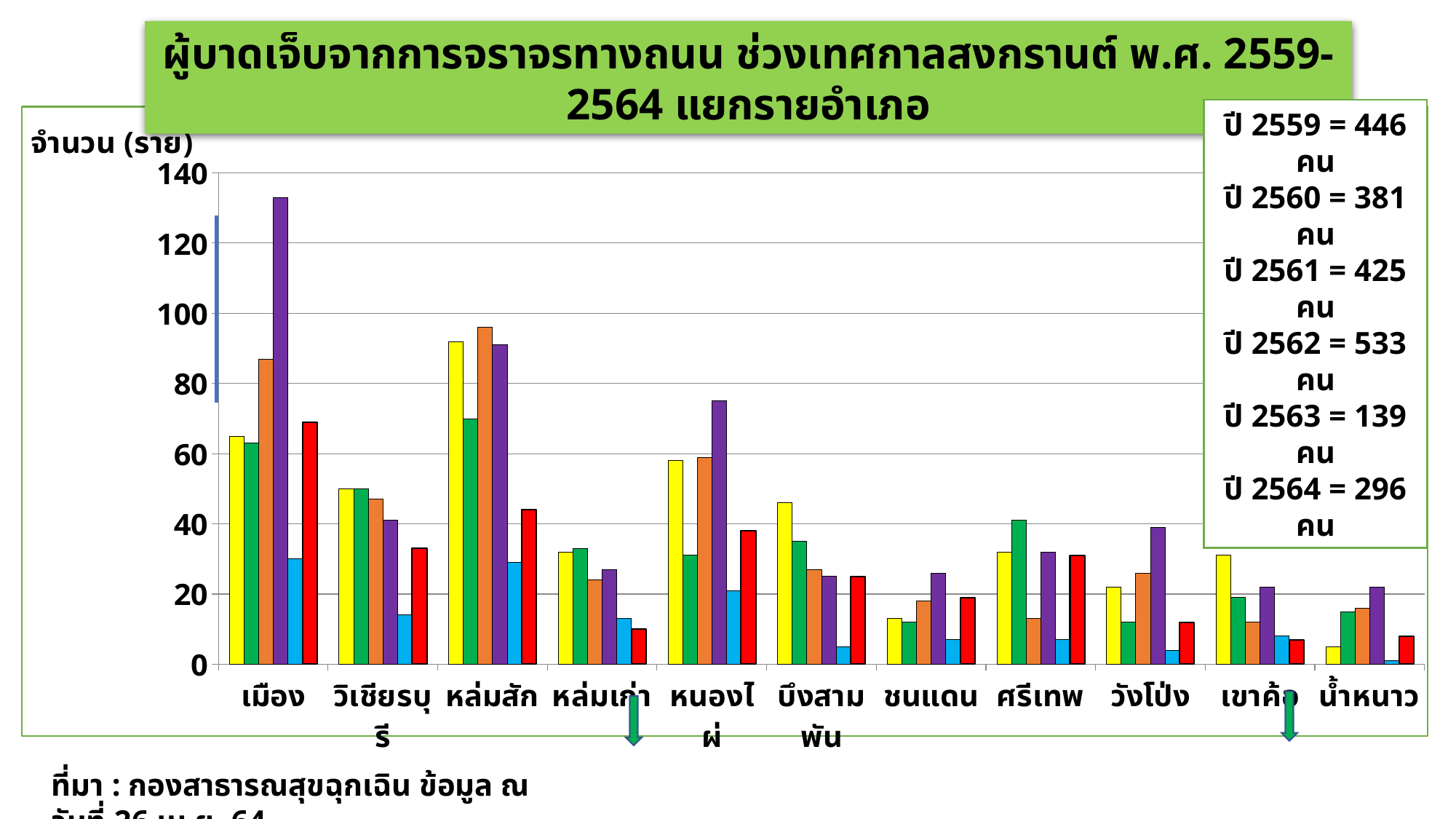
How many bars are plotted for each district? 6 Is the value of the purple bar for หนองไผ่ greater or less than 60? greater What kind of chart is shown on the slide? bar chart Which is larger: the yellow bar for เมือง or the yellow bar for หล่มสัก? หล่มสัก Which district has the tallest bar in the chart? เมือง Is the value of the orange bar for หล่มสัก greater or less than 80? greater What is the label on the vertical axis of the chart? จำนวน (ราย) How many districts (categories) are shown along the x axis? 11 Is the value of the red bar for หล่มเก่า greater or less than 20? less According to the text box beside the chart, how many people were injured in ปี 2562? 533 คน Which is larger: the purple bar for เมือง or the purple bar for หล่มสัก? เมือง